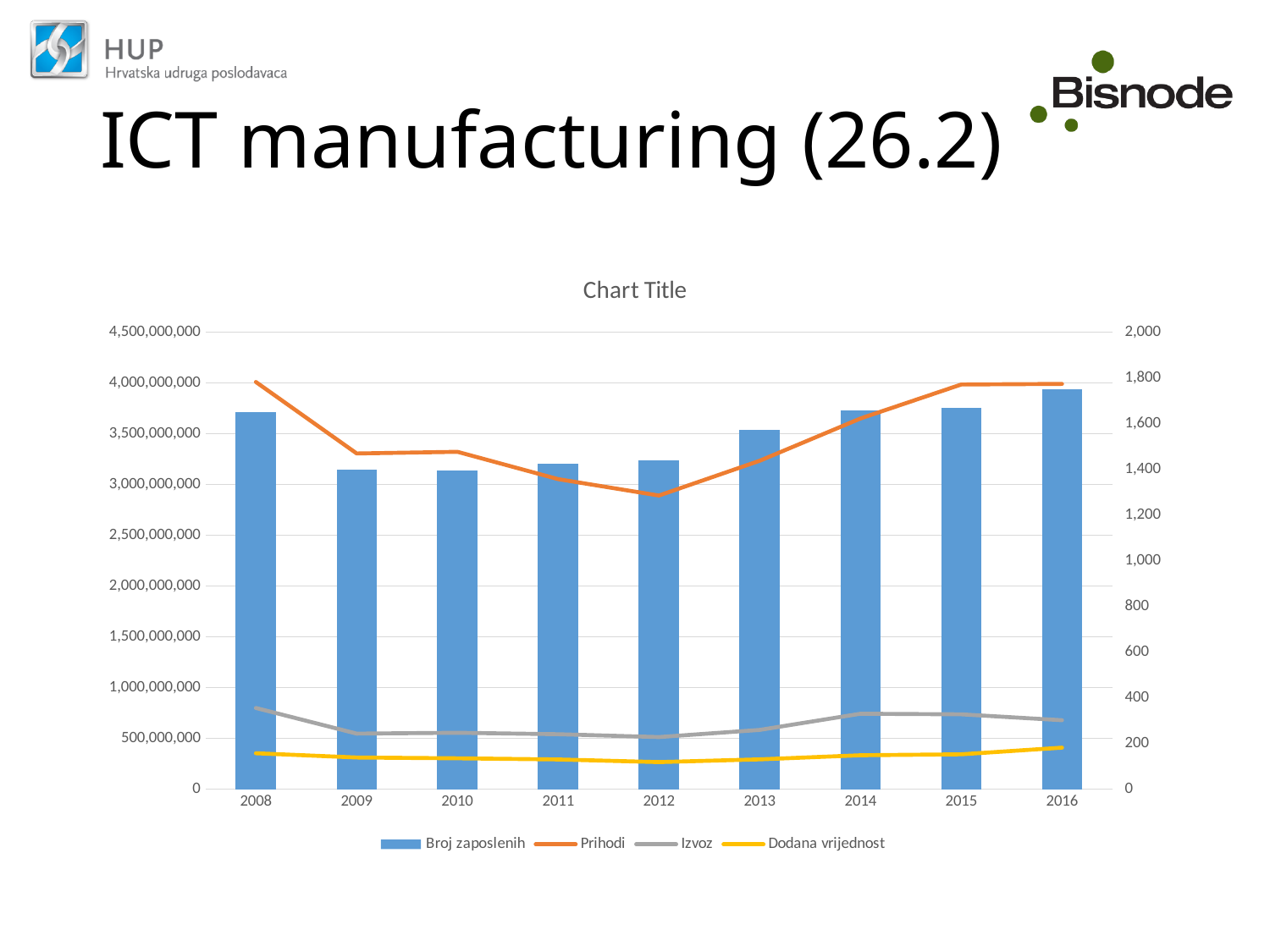
Which series is drawn in yellow in the legend? Dodana vrijednost Is the Broj zaposlenih bar for 2009 greater or less than 1,600 on the right axis? less Does the Prihodi line rise or fall from 2012 to 2016? rises Is the Prihodi value for 2008 greater or less than 3,500,000,000? greater What kind of chart is shown on the slide? A combined bar and line chart In which year is the Prihodi line at its lowest? 2012 How many series does the legend list? 4 Which is larger, the Prihodi value for 2008 or for 2012? 2008 Is the Izvoz value for 2008 greater or less than 500,000,000? greater Which year has the highest bar for Broj zaposlenih? 2016 How many years are shown on the x axis? 9